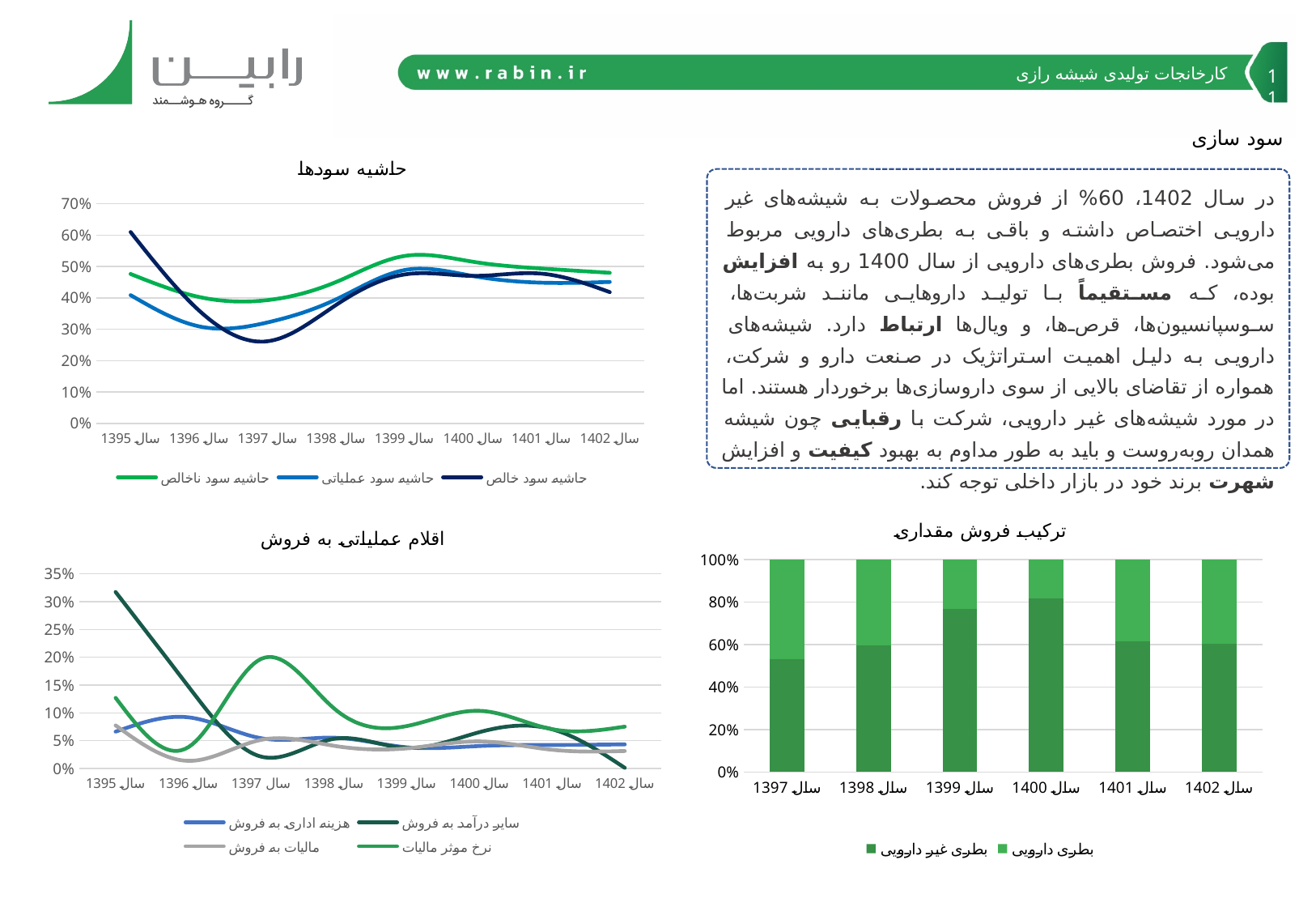
In the chart titled اقلام عملیاتی به فروش, is the value of سایر درآمد به فروش for سال 1395 greater or less than 30%? greater In the chart titled حاشیه سودها, is the value of حاشیه سود خالص for سال 1395 greater or less than 50%? greater In the chart titled حاشیه سودها, how many years are shown on the x axis? 8 In the chart titled حاشیه سودها, in which year is حاشیه سود خالص at its lowest? سال 1397 In the chart titled ترکیب فروش مقداری, is the share of بطری غیر دارویی for سال 1400 greater or less than 80%? greater In the chart titled ترکیب فروش مقداری, how many bars are shown? 6 What kind of chart is the chart titled ترکیب فروش مقداری? stacked bar chart In the chart titled اقلام عملیاتی به فروش, how many series does the legend list? 4 What kind of chart is the chart titled حاشیه سودها? line chart In the chart titled حاشیه سودها, how many series does the legend list? 3 In the chart titled اقلام عملیاتی به فروش, in which year does نرخ موثر مالیات reach its highest value? سال 1397